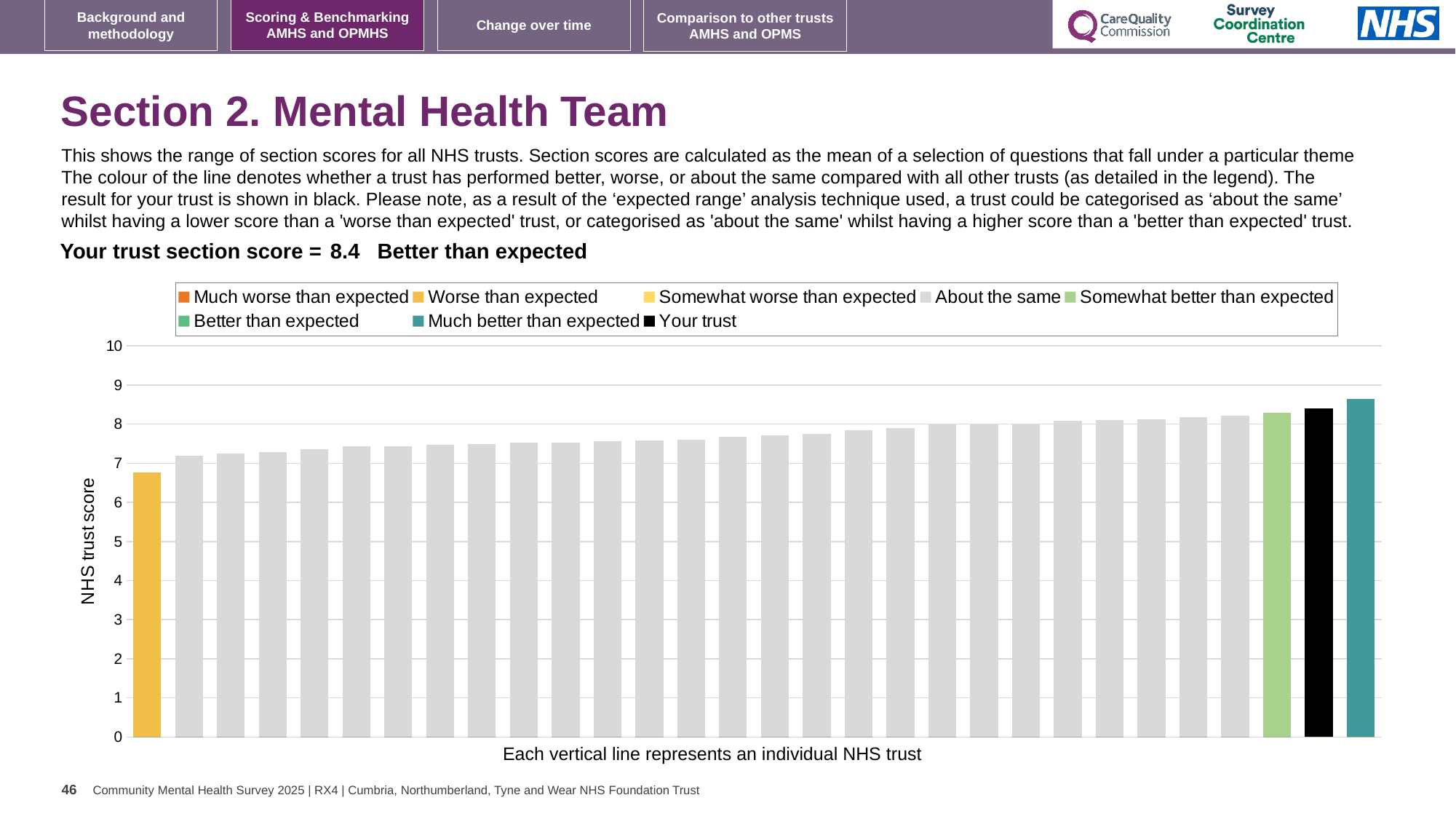
Which category does your trust's section score fall into according to the slide? Better than expected Which legend category does the highest bar in the chart belong to? Much better than expected Is the value of the rightmost (teal) bar greater or less than 9? less Is the value of the leftmost (yellow) bar greater or less than 7? less What kind of chart is shown on the slide? Bar chart Is the value of the black 'Your trust' bar greater or less than 8? greater Which legend category does the lowest bar in the chart belong to? Worse than expected Do the bar values rise or fall from left to right across the chart? Rise What is the section score for your trust shown on the slide? 8.4 How many entries does the chart legend list? 8 What is the label on the vertical axis of the chart? NHS trust score Which is taller: the black 'Your trust' bar or the teal 'Much better than expected' bar? The teal 'Much better than expected' bar